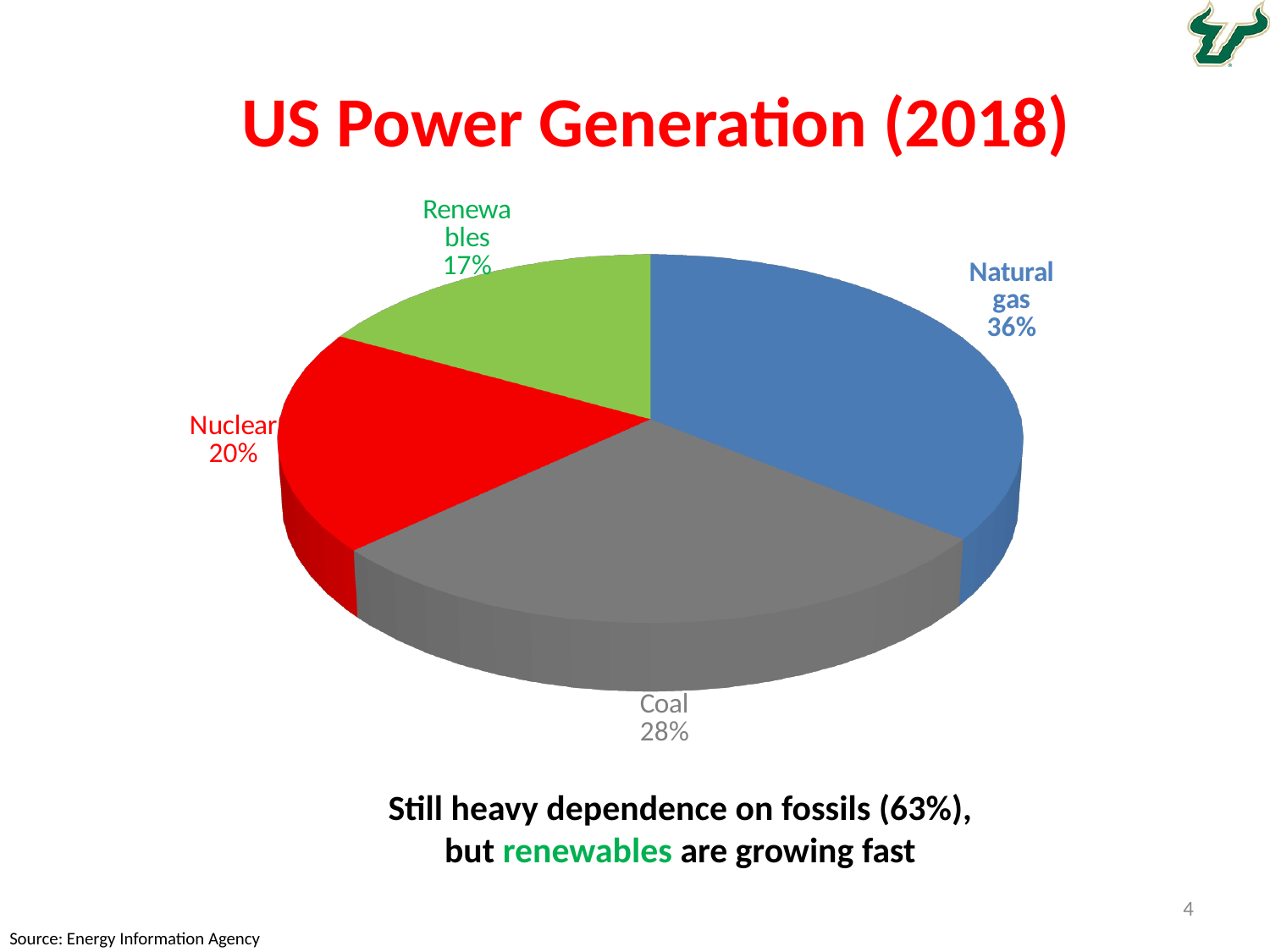
What share of US power generation in 2018 comes from renewables? 17% What is the title of the chart on the slide? US Power Generation (2018) What share of US power generation in 2018 comes from coal? 28% Which source has the smallest share of US power generation in 2018? Renewables How many percentage points larger is the nuclear share than the renewables share? 3 What kind of chart is shown on the slide? Pie chart Which has a larger share of US power generation, coal or nuclear? Coal What share of US power generation in 2018 comes from natural gas? 36% What share of US power generation in 2018 comes from nuclear? 20% Which source has the largest share of US power generation in 2018? Natural gas How many percentage points larger is the natural gas share than the coal share? 8 How many sources are shown in the pie chart? 4